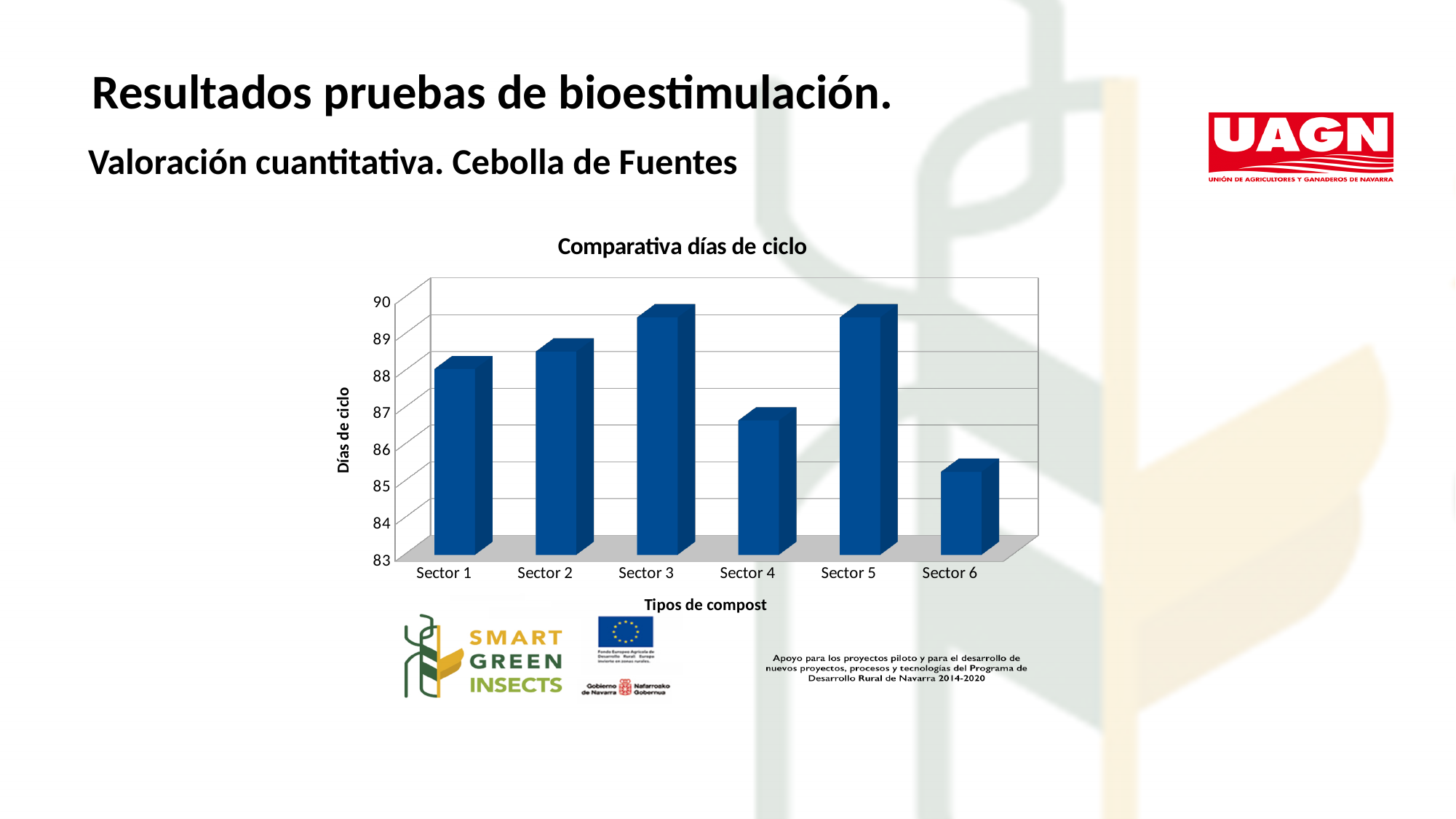
Which has a higher value, Sector 2 or Sector 6? Sector 2 Which has a higher value, Sector 1 or Sector 4? Sector 1 Is the value for Sector 6 greater or less than 84? greater Is the value for Sector 3 greater or less than 88? greater Is the value for Sector 4 greater or less than 88? less How many sectors are plotted in the chart? 6 Which sector has the lowest value in the chart? Sector 6 What kind of chart is shown on the slide? bar chart What is the title of the chart? Comparativa días de ciclo What is the label of the vertical axis of the chart? Días de ciclo